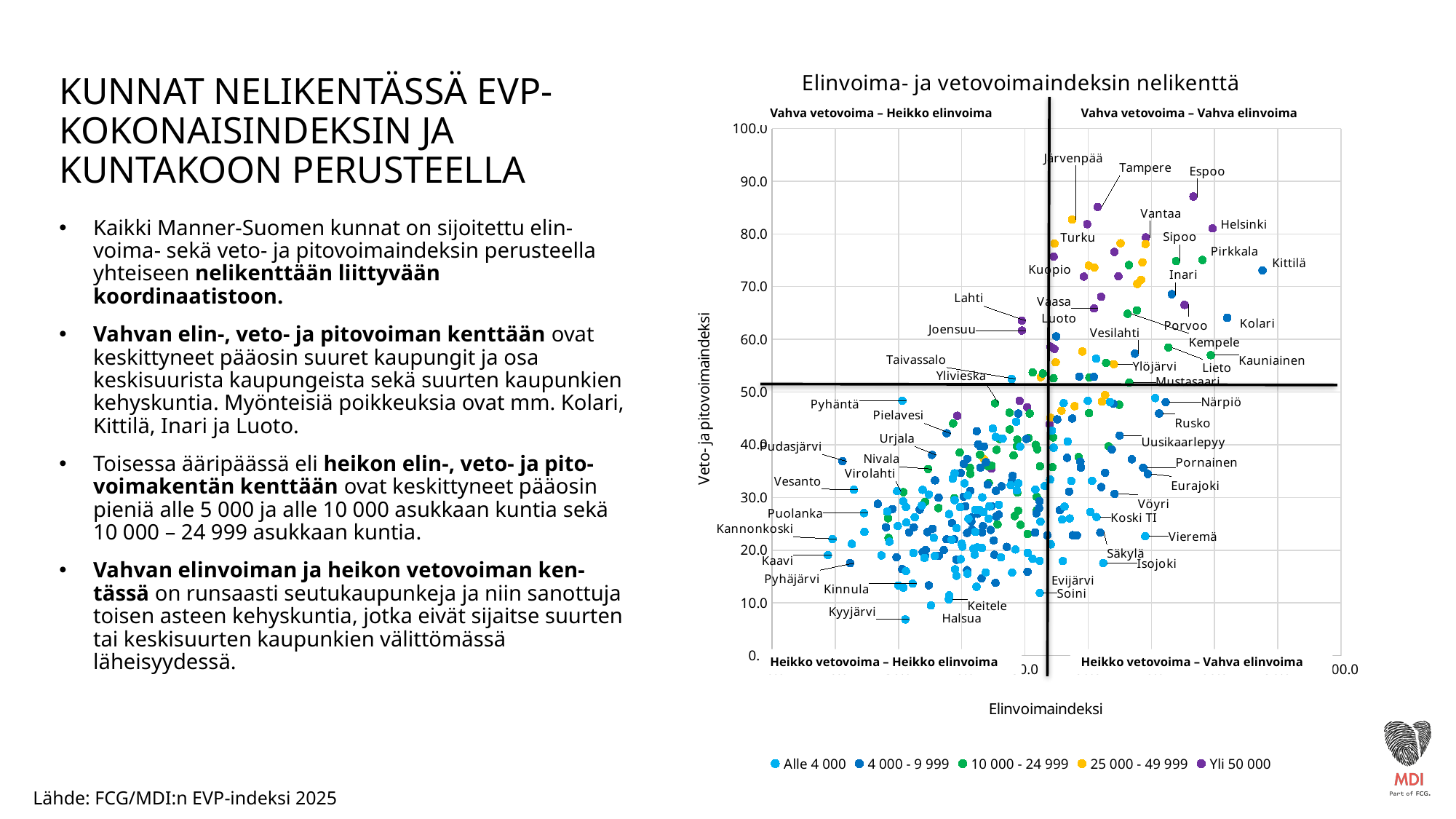
Is the Veto- ja pitovoimaindeksi value for Kittilä greater or less than 60? greater How many series does the legend list? 5 What is the title of the chart? Elinvoima- ja vetovoimaindeksin nelikenttä Is the Veto- ja pitovoimaindeksi value for Kinnula greater or less than 20? less What is the label of the vertical axis? Veto- ja pitovoimaindeksi Which has the higher Veto- ja pitovoimaindeksi value, Helsinki or Kolari? Helsinki Is the Veto- ja pitovoimaindeksi value for Tampere greater or less than 80? greater Which has the higher Veto- ja pitovoimaindeksi value, Espoo or Kyyjärvi? Espoo What kind of chart is shown on the slide? Scatter chart